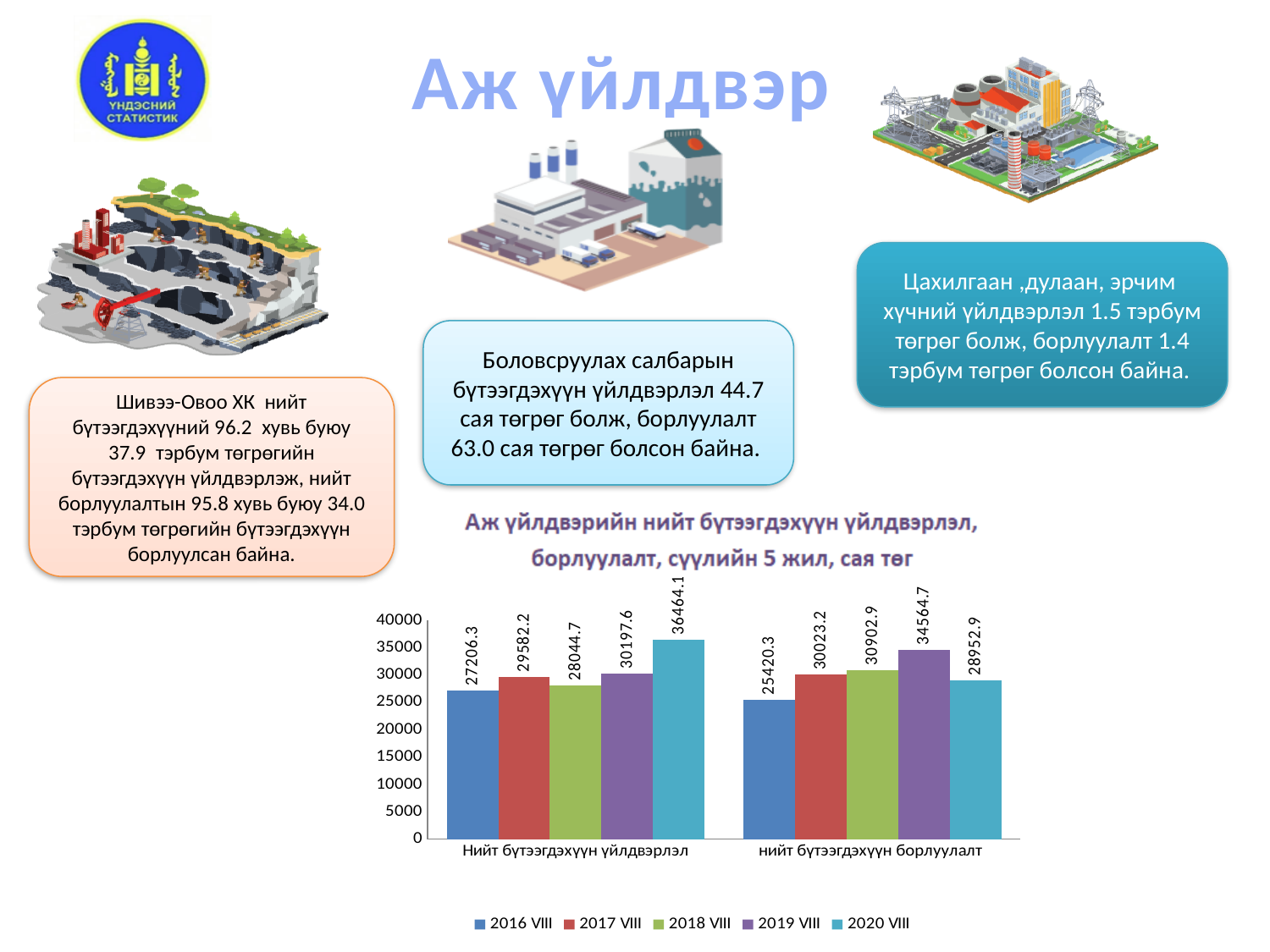
Which series has the highest value in the category 'Нийт бүтээгдэхүүн үйлдвэрлэл'? 2020 VIII What type of chart is shown on the slide? bar chart What is the value for 2019 VIII in the category 'нийт бүтээгдэхүүн борлуулалт'? 34564.7 What is the title of the chart? Аж үйлдвэрийн нийт бүтээгдэхүүн үйлдвэрлэл, борлуулалт, сүүлийн 5 жил, сая төг Which is larger: the 2018 VIII value for 'Нийт бүтээгдэхүүн үйлдвэрлэл' or the 2018 VIII value for 'нийт бүтээгдэхүүн борлуулалт'? нийт бүтээгдэхүүн борлуулалт Which series has the lowest value in the category 'нийт бүтээгдэхүүн борлуулалт'? 2016 VIII Is the value for 2017 VIII in the category 'Нийт бүтээгдэхүүн үйлдвэрлэл' greater or less than 30000? less What is the difference between the 2020 VIII and 2016 VIII values in the category 'Нийт бүтээгдэхүүн үйлдвэрлэл'? 9257.8 What is the value for 2016 VIII in the category 'нийт бүтээгдэхүүн борлуулалт'? 25420.3 How many series does the chart legend list? 5 What is the value for 2020 VIII in the category 'Нийт бүтээгдэхүүн үйлдвэрлэл'? 36464.1 How many categories are shown on the x axis of the chart? 2